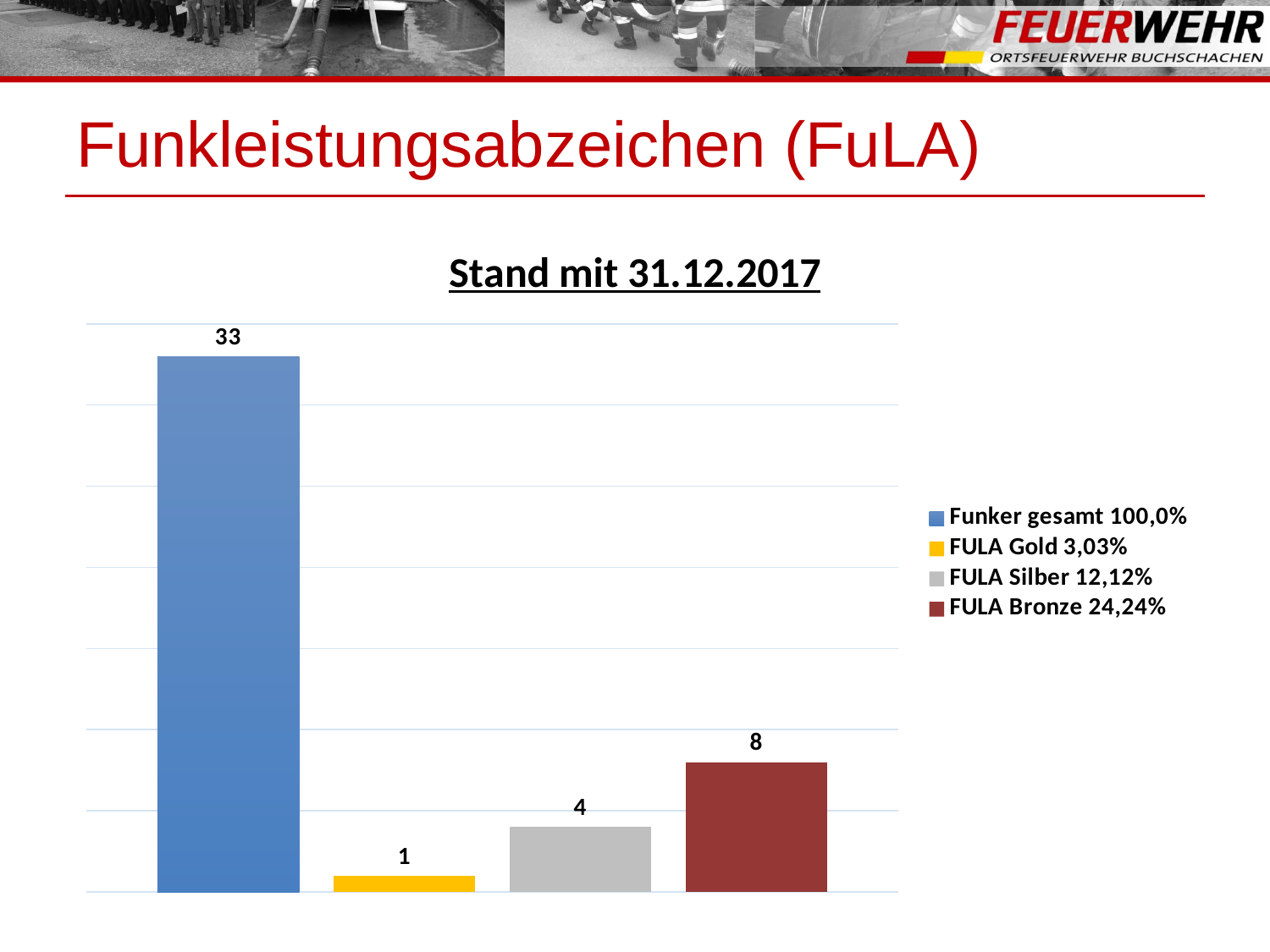
Which series has the highest value? Funker gesamt Which series has the lowest value? FULA Gold How many bars are plotted in the chart? 4 What is the value for FULA Bronze? 8 What is the value for FULA Silber? 4 How many series does the legend list? 4 What is the difference between the values for FULA Bronze and FULA Silber? 4 What is the value for FULA Gold? 1 What is the value for Funker gesamt? 33 What is the title of the chart? Stand mit 31.12.2017 What kind of chart is shown on the slide? Bar chart Which is larger, the value for FULA Silber or the value for FULA Gold? FULA Silber